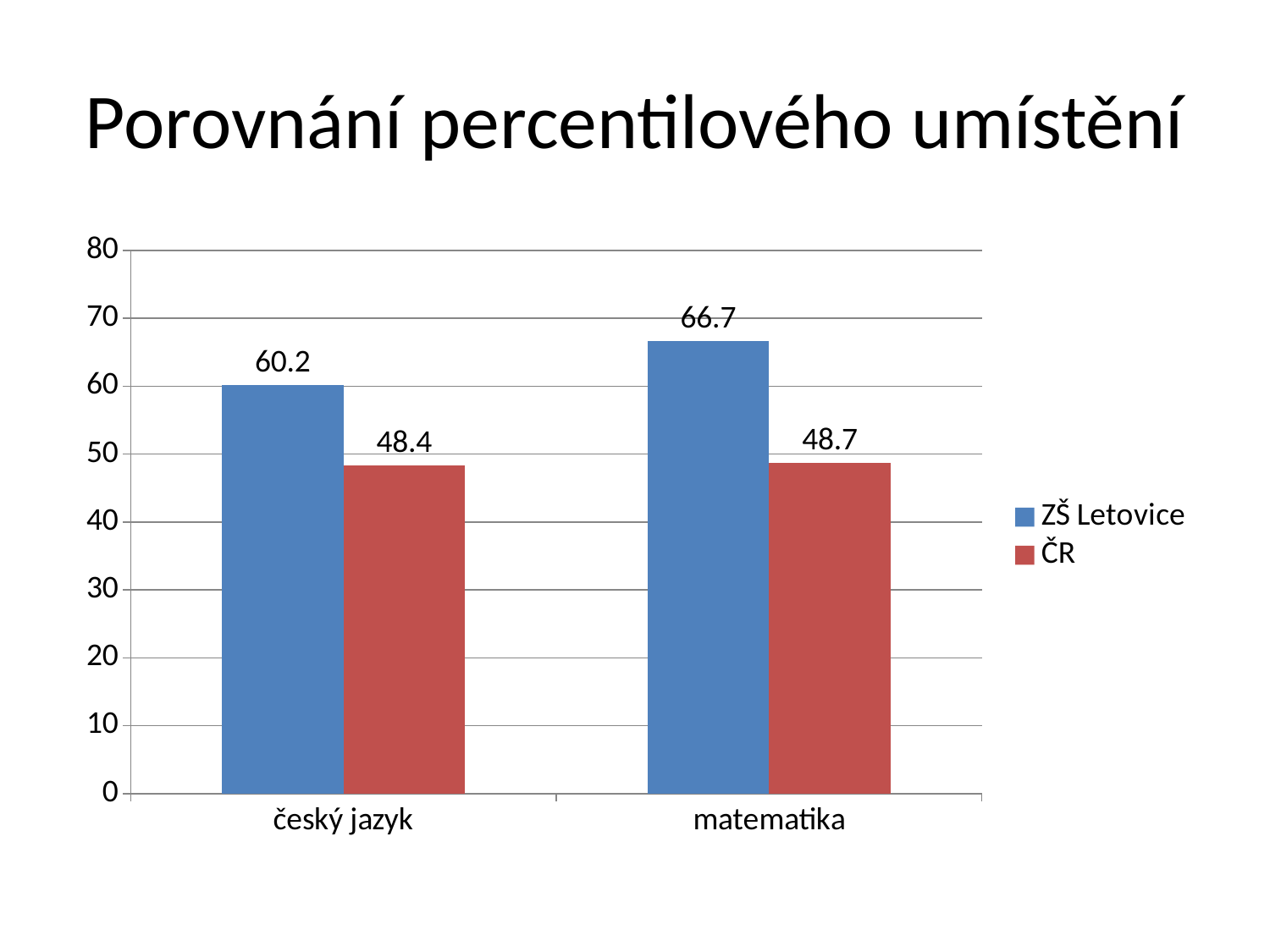
What is the difference between ZŠ Letovice and ČR in matematika? 18 In which category does ZŠ Letovice have its highest value? matematika What is the value for ČR in český jazyk? 48.4 What is the difference between ZŠ Letovice and ČR in český jazyk? 11.8 How many categories are shown on the x axis? 2 What kind of chart is shown on the slide? bar chart Which is larger in český jazyk, ZŠ Letovice or ČR? ZŠ Letovice How many series does the legend list? 2 What is the value for ZŠ Letovice in matematika? 66.7 What is the value for ZŠ Letovice in český jazyk? 60.2 Which bar has the lowest value on the chart? ČR in český jazyk What is the value for ČR in matematika? 48.7